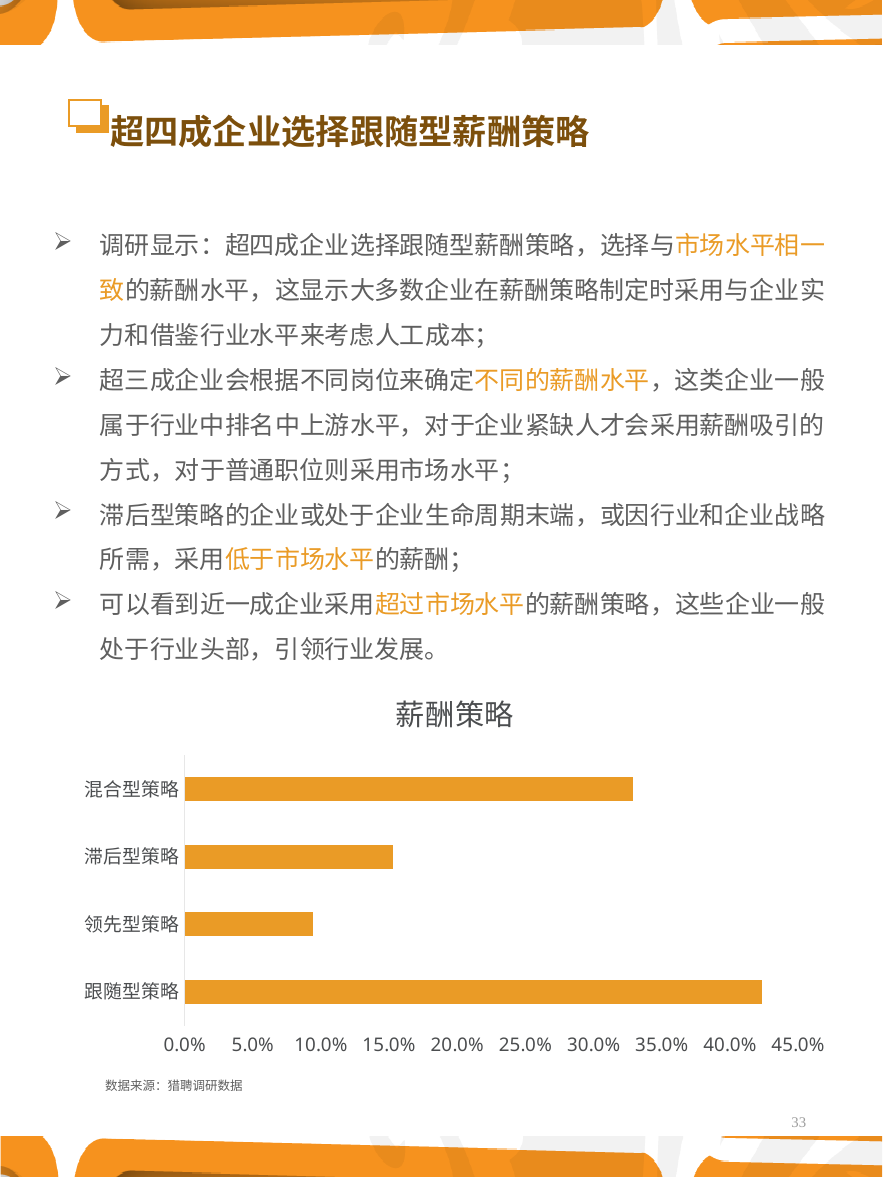
Is the value for 混合型策略 greater or less than 30.0%? greater Which category has the lowest value in the 薪酬策略 chart? 领先型策略 What is the highest value shown on the x axis of the 薪酬策略 chart? 45.0% Is the value for 跟随型策略 greater or less than 40.0%? greater Which category has the highest value in the 薪酬策略 chart? 跟随型策略 Which is larger in the 薪酬策略 chart, 滞后型策略 or 领先型策略? 滞后型策略 Is the value for 领先型策略 greater or less than 15.0%? less How many categories are plotted in the 薪酬策略 chart? 4 What kind of chart is shown under the title 薪酬策略? bar chart What is the title of the chart on the slide? 薪酬策略 Which is larger in the 薪酬策略 chart, 混合型策略 or 滞后型策略? 混合型策略